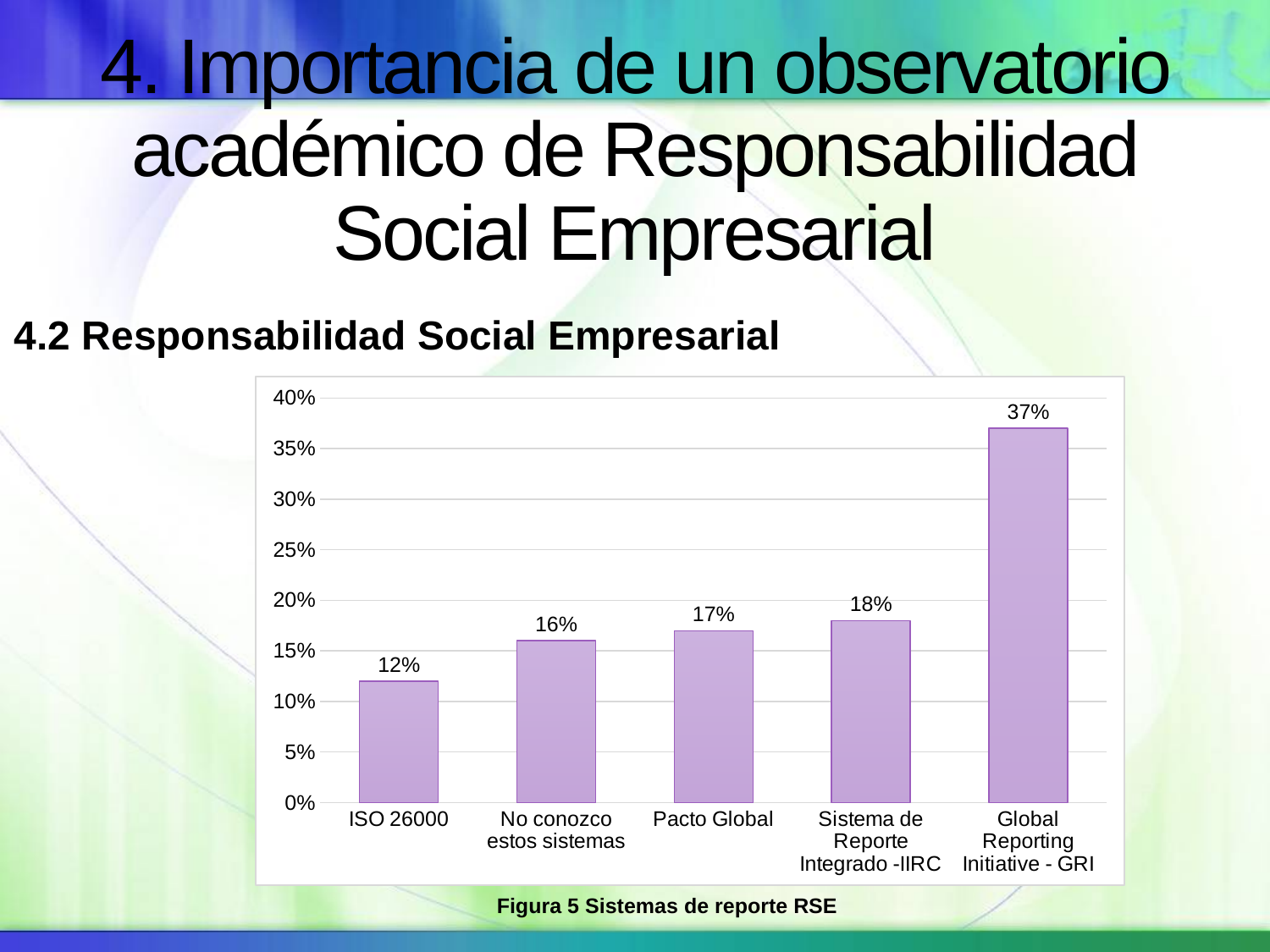
What is the value for ISO 26000? 12% Which category has the highest value? Global Reporting Initiative - GRI What is the value for Sistema de Reporte Integrado -IIRC? 18% Which is larger, the value for No conozco estos sistemas or the value for ISO 26000? No conozco estos sistemas Which category has the lowest value? ISO 26000 What is the value for Pacto Global? 17% How many categories are shown on the x axis? 5 What is the caption shown below the chart? Figura 5 Sistemas de reporte RSE What is the difference between the values for Global Reporting Initiative - GRI and ISO 26000? 25% What kind of chart is shown on the slide? bar chart What is the value for Global Reporting Initiative - GRI? 37% Is the value for Global Reporting Initiative - GRI greater or less than 35%? greater